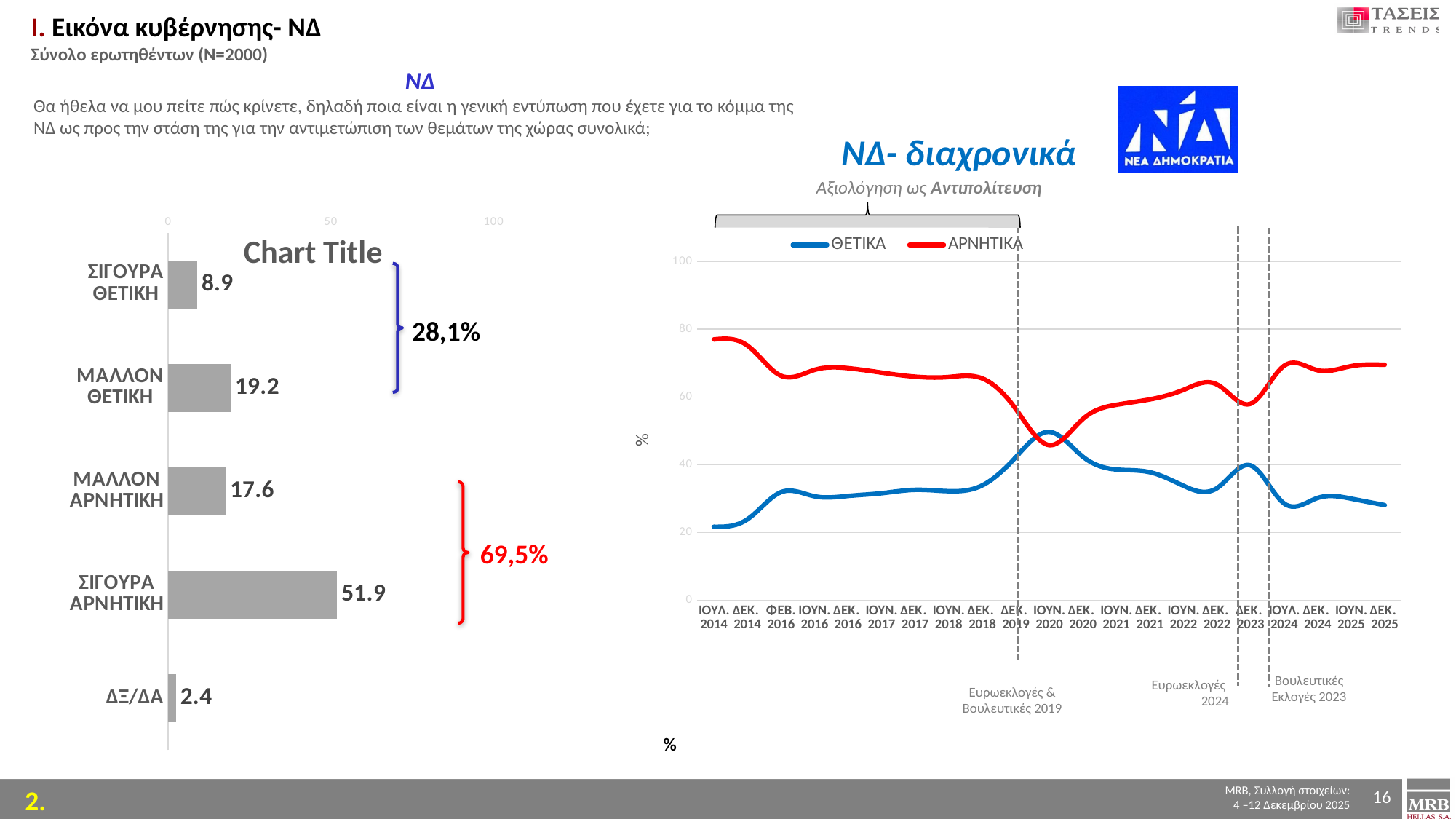
How many categories does the left bar chart show? 5 On the left bar chart, what is the value for ΣΙΓΟΥΡΑ ΑΡΝΗΤΙΚΗ? 51.9 On the ΝΔ- διαχρονικά chart, is the ΑΡΝΗΤΙΚΑ value for ΙΟΥΛ. 2014 greater or less than 60? greater On the left bar chart, which is larger: ΜΑΛΛΟΝ ΘΕΤΙΚΗ or ΣΙΓΟΥΡΑ ΘΕΤΙΚΗ? ΜΑΛΛΟΝ ΘΕΤΙΚΗ What kind of chart is the chart titled ΝΔ- διαχρονικά? line chart On the left bar chart, what is the difference between ΣΙΓΟΥΡΑ ΑΡΝΗΤΙΚΗ and ΜΑΛΛΟΝ ΑΡΝΗΤΙΚΗ? 34.3 On the left bar chart, which category has the highest value? ΣΙΓΟΥΡΑ ΑΡΝΗΤΙΚΗ On the left bar chart, what is the value for ΜΑΛΛΟΝ ΘΕΤΙΚΗ? 19.2 How many series does the legend of the ΝΔ- διαχρονικά chart list? 2 On the left bar chart, what is the value for ΔΞ/ΔΑ? 2.4 On the left bar chart, which category has the lowest value? ΔΞ/ΔΑ On the ΝΔ- διαχρονικά chart, which series is drawn in red? ΑΡΝΗΤΙΚΑ